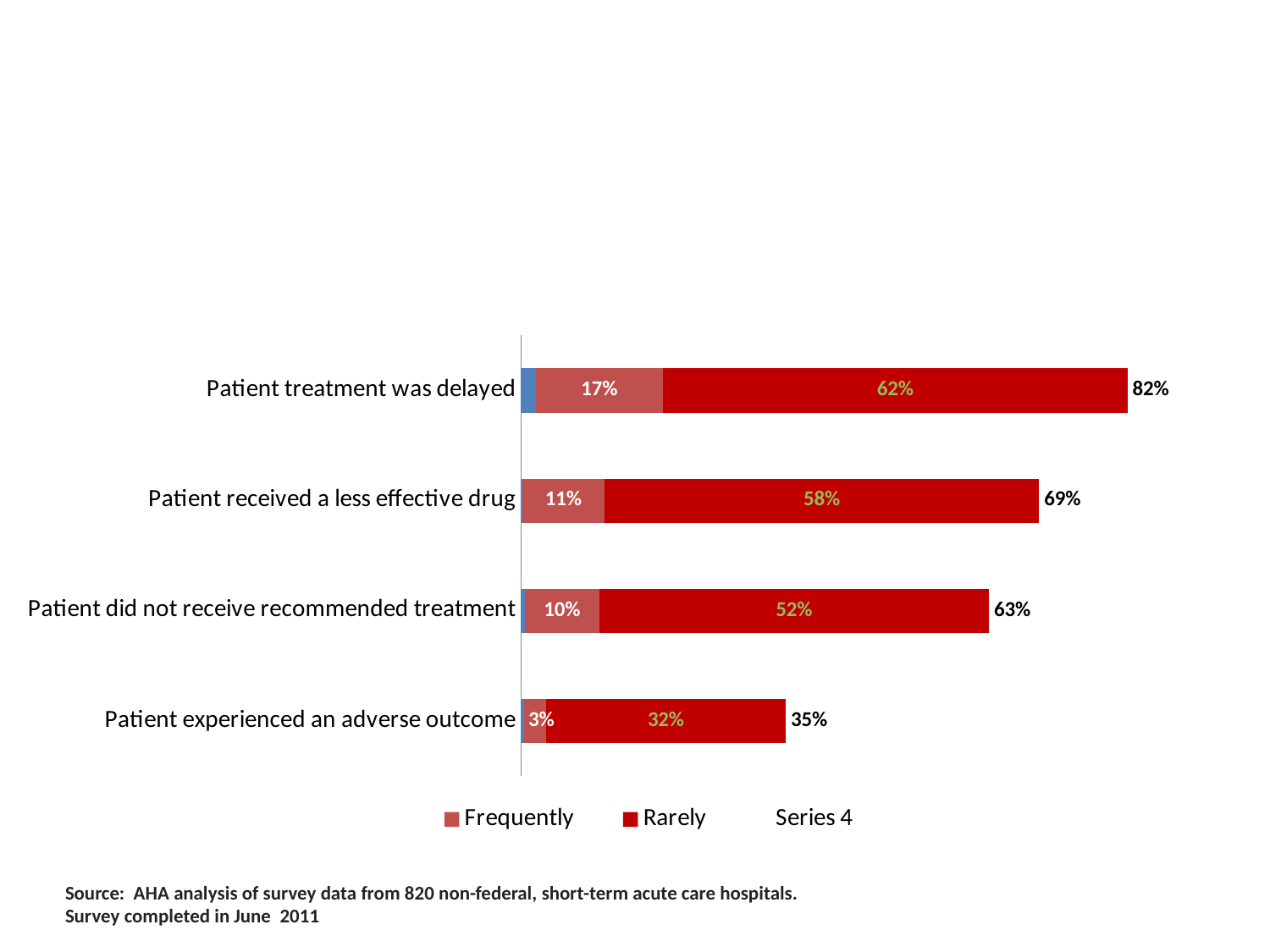
What is the 'Rarely' value for 'Patient received a less effective drug'? 58% How many categories are plotted in the chart? 4 What is the difference between the 'Rarely' values for 'Patient treatment was delayed' and 'Patient received a less effective drug'? 4% Which is larger: the 'Frequently' value for 'Patient received a less effective drug' or for 'Patient did not receive recommended treatment'? Patient received a less effective drug Which category has the highest 'Rarely' value? Patient treatment was delayed What is the 'Rarely' value for 'Patient experienced an adverse outcome'? 32% What kind of chart is shown on the slide? bar chart What is the 'Frequently' value for 'Patient treatment was delayed'? 17% What is the total printed at the end of the bar for 'Patient did not receive recommended treatment'? 63% What is the name of the third series listed in the legend? Series 4 Which category has the lowest 'Frequently' value? Patient experienced an adverse outcome How many series does the legend list? 3